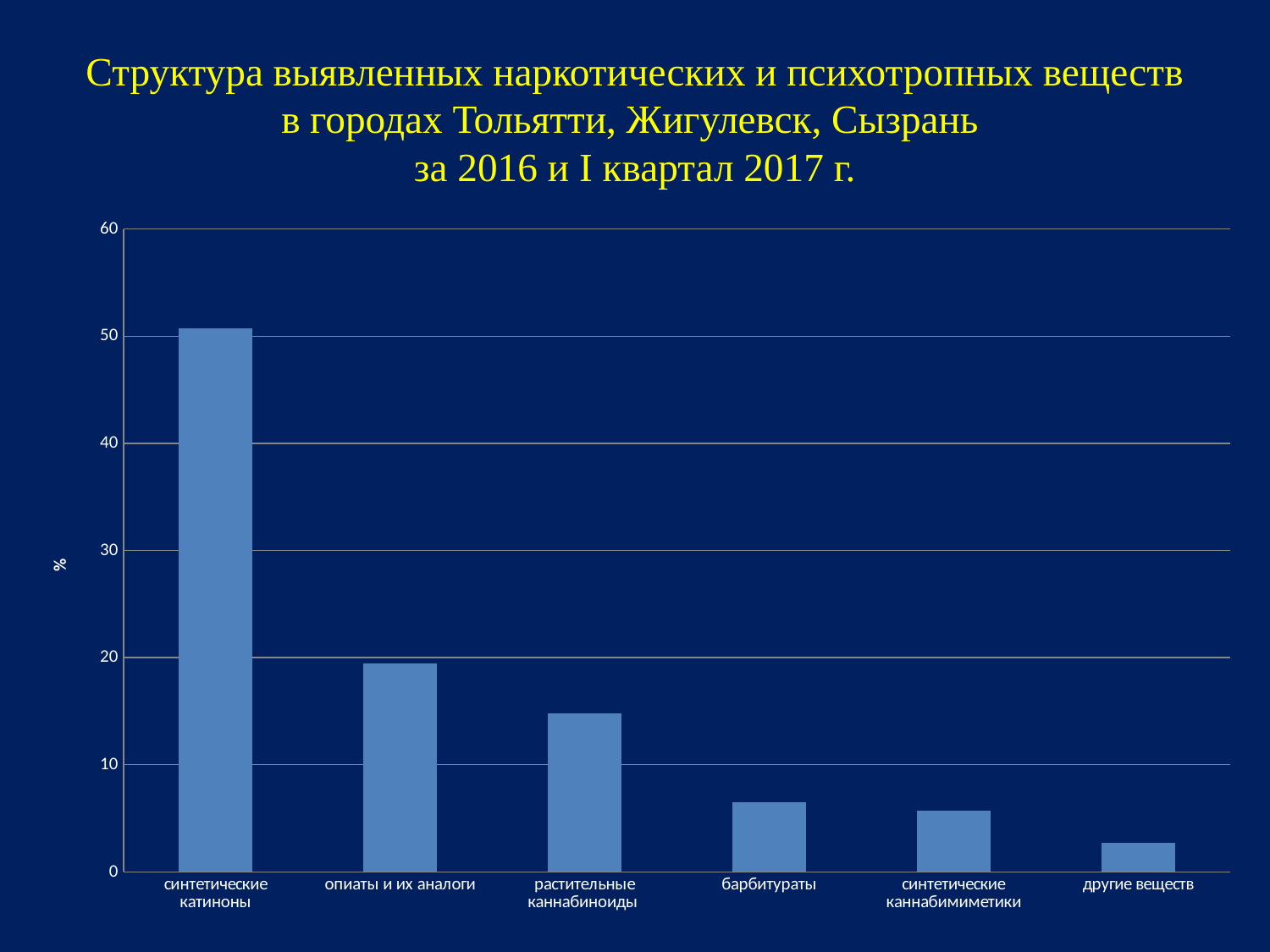
Which category has the highest value in the chart? синтетические катиноны Which category has the lowest value in the chart? другие веществ What kind of chart is shown on the slide? bar chart Is the value for барбитураты greater or less than 10? less Is the value for растительные каннабиноиды greater or less than 10? greater Do the values rise or fall moving from left to right along the x axis? fall Is the value for синтетические катиноны greater or less than 40? greater Which is larger, the value for опиаты и их аналоги or the value for растительные каннабиноиды? опиаты и их аналоги What is the label on the vertical axis of the chart? % How many categories are shown on the x axis of the chart? 6